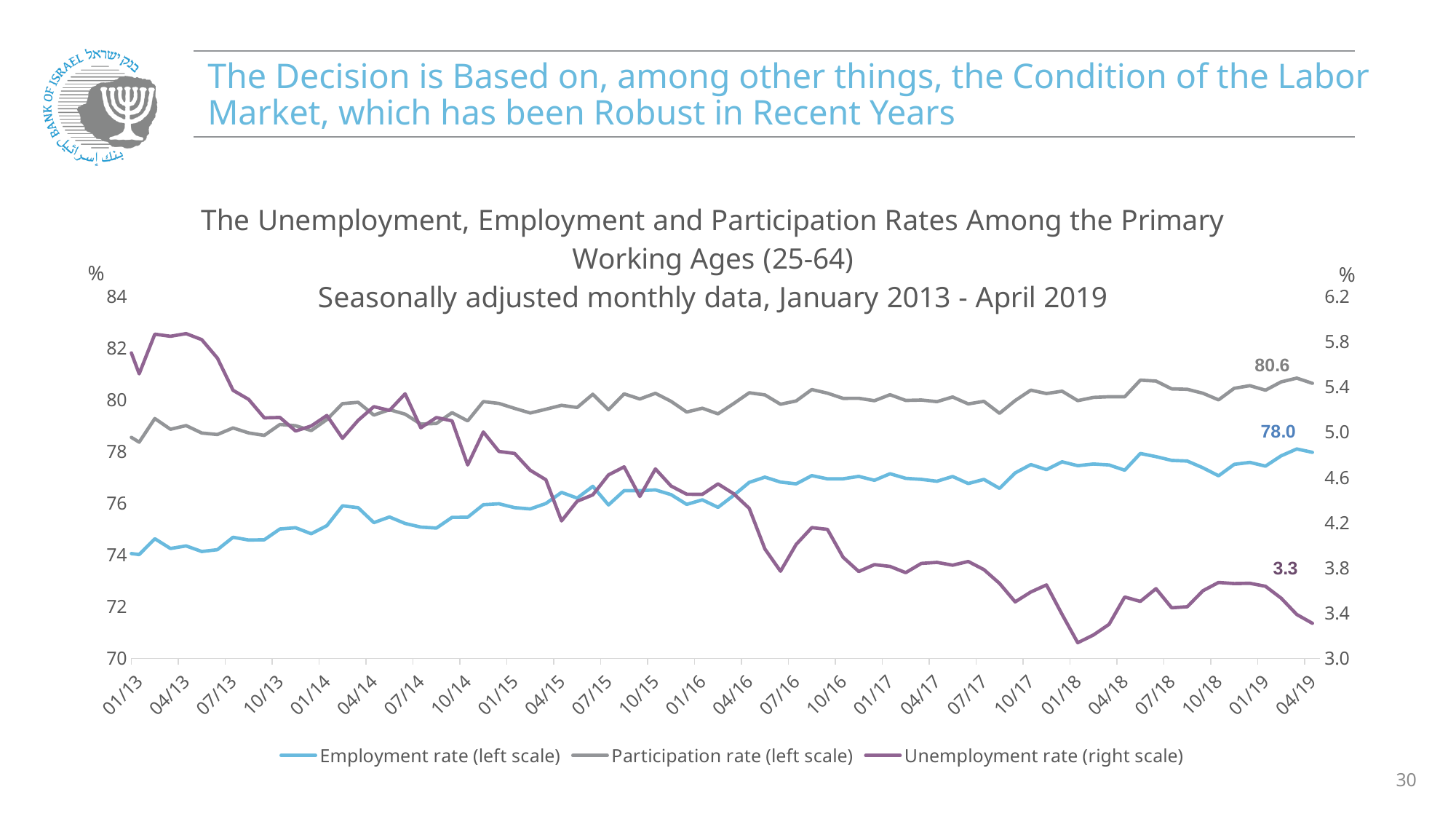
How many series does the legend list? 3 What is the unemployment rate value labelled at the end of the series (04/19)? 3.3 What is the difference between the labelled participation rate (80.6) and the labelled employment rate (78.0) at the end of the series? 2.6 What is the participation rate value labelled at the end of the series (04/19)? 80.6 Is the employment rate at 01/13 greater or less than 76 on the left scale? less Does the employment rate rise or fall overall from 01/13 to 04/19? rise Is the unemployment rate at 01/13 greater or less than 5.4 on the right scale? greater What type of chart is shown on the slide? line chart What is the employment rate value labelled at the end of the series (04/19)? 78.0 At the end of the series, which is higher on the left scale: the participation rate or the employment rate? Participation rate Which series is plotted on the right scale according to the legend? Unemployment rate Does the unemployment rate rise or fall overall from 01/13 to 04/19? fall